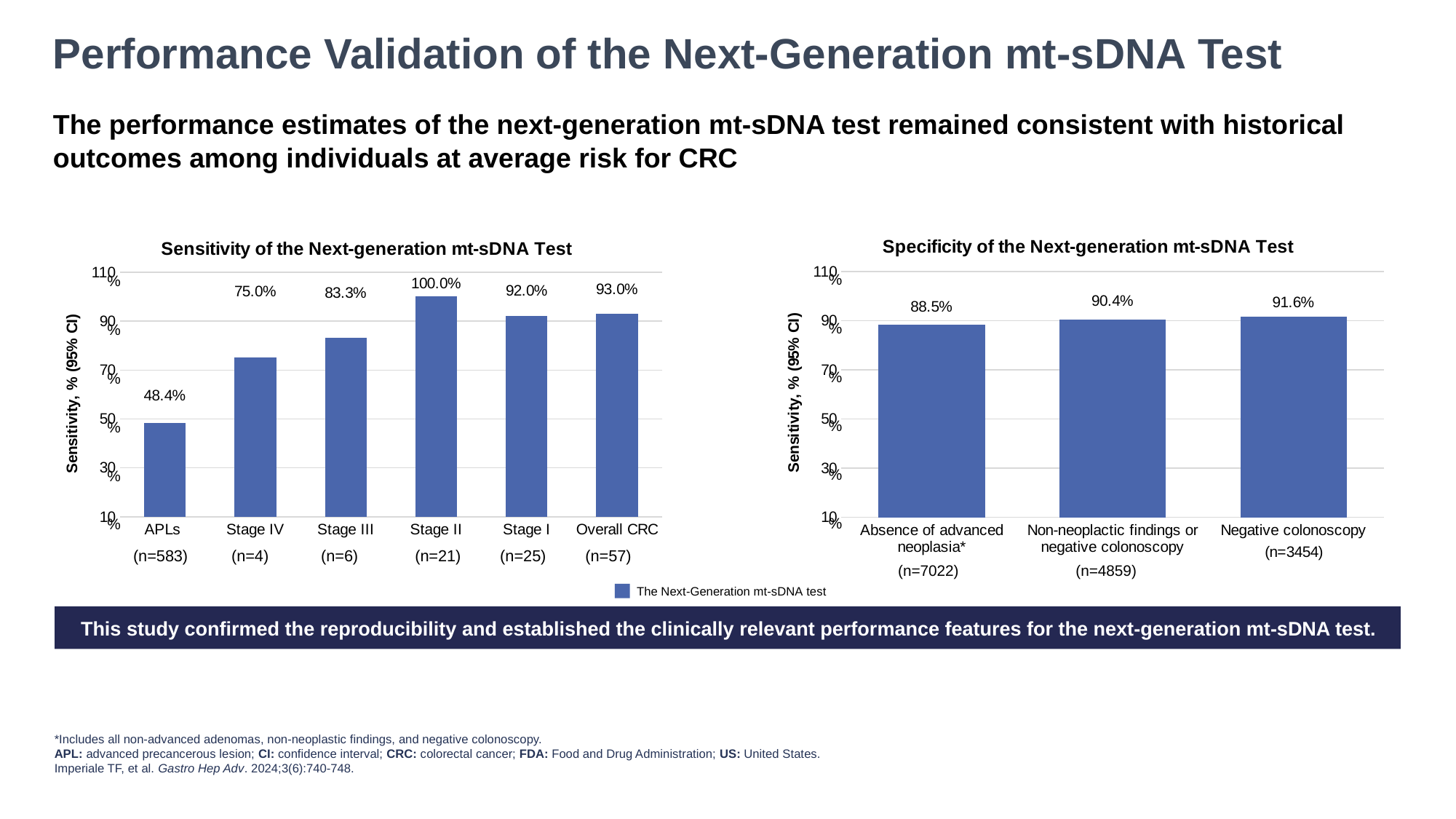
In the Sensitivity of the Next-generation mt-sDNA Test chart, which category has the highest value? Stage II In the Specificity of the Next-generation mt-sDNA Test chart, what is the value for Absence of advanced neoplasia*? 88.5% In the Sensitivity of the Next-generation mt-sDNA Test chart, what is the value for APLs? 48.4% In the Sensitivity of the Next-generation mt-sDNA Test chart, what is the value for Stage III? 83.3% How many categories are shown in the Sensitivity of the Next-generation mt-sDNA Test chart? 6 In the Sensitivity of the Next-generation mt-sDNA Test chart, what is the difference between the Overall CRC value and the Stage IV value? 18.0% In the Specificity of the Next-generation mt-sDNA Test chart, what is the difference between the Negative colonoscopy value and the Absence of advanced neoplasia* value? 3.1% In the Specificity of the Next-generation mt-sDNA Test chart, what is the value for Negative colonoscopy? 91.6% In the Sensitivity of the Next-generation mt-sDNA Test chart, which is larger, the value for Stage I or the value for Stage III? Stage I How many series does the legend below the charts list? 1 What kind of chart is the Specificity of the Next-generation mt-sDNA Test chart? Bar chart In the Sensitivity of the Next-generation mt-sDNA Test chart, which category has the lowest value? APLs